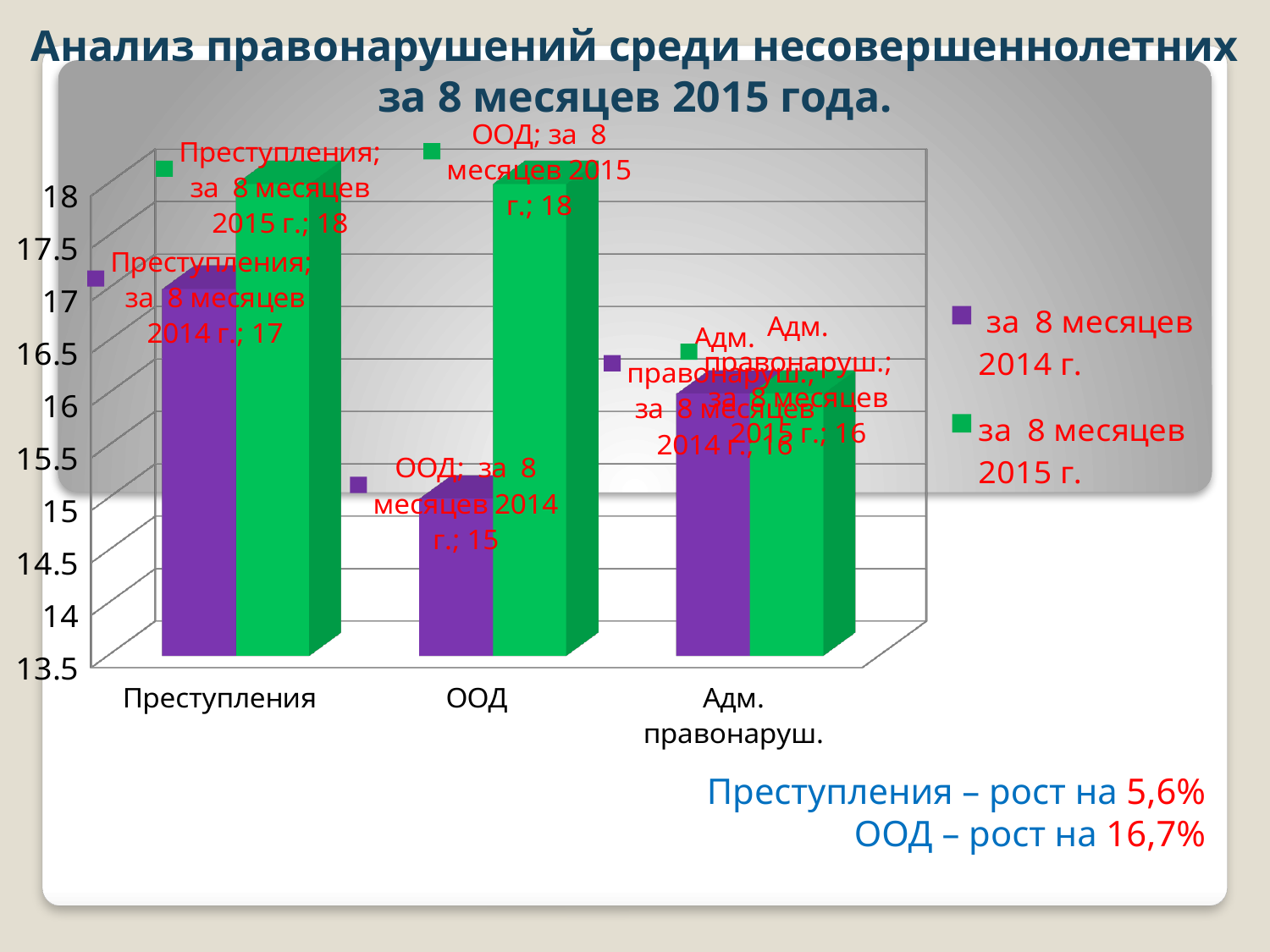
What is the value for ООД in the series 'за 8 месяцев 2014 г.'? 15 How many series does the legend list? 2 Which is larger for Преступления: the 2014 value or the 2015 value? the 2015 value How many categories are shown on the x axis? 3 What kind of chart is shown on the slide? bar chart Which category has the lowest value in the series 'за 8 месяцев 2014 г.'? ООД What is the difference between the 2015 and 2014 values for ООД? 3 What is the value for Преступления in the series 'за 8 месяцев 2014 г.'? 17 What is the value for ООД in the series 'за 8 месяцев 2015 г.'? 18 What is the title of the chart? Анализ правонарушений среди несовершеннолетних за 8 месяцев 2015 года. What is the value for Преступления in the series 'за 8 месяцев 2015 г.'? 18 What is the value for Адм. правонаруш. in the series 'за 8 месяцев 2015 г.'? 16